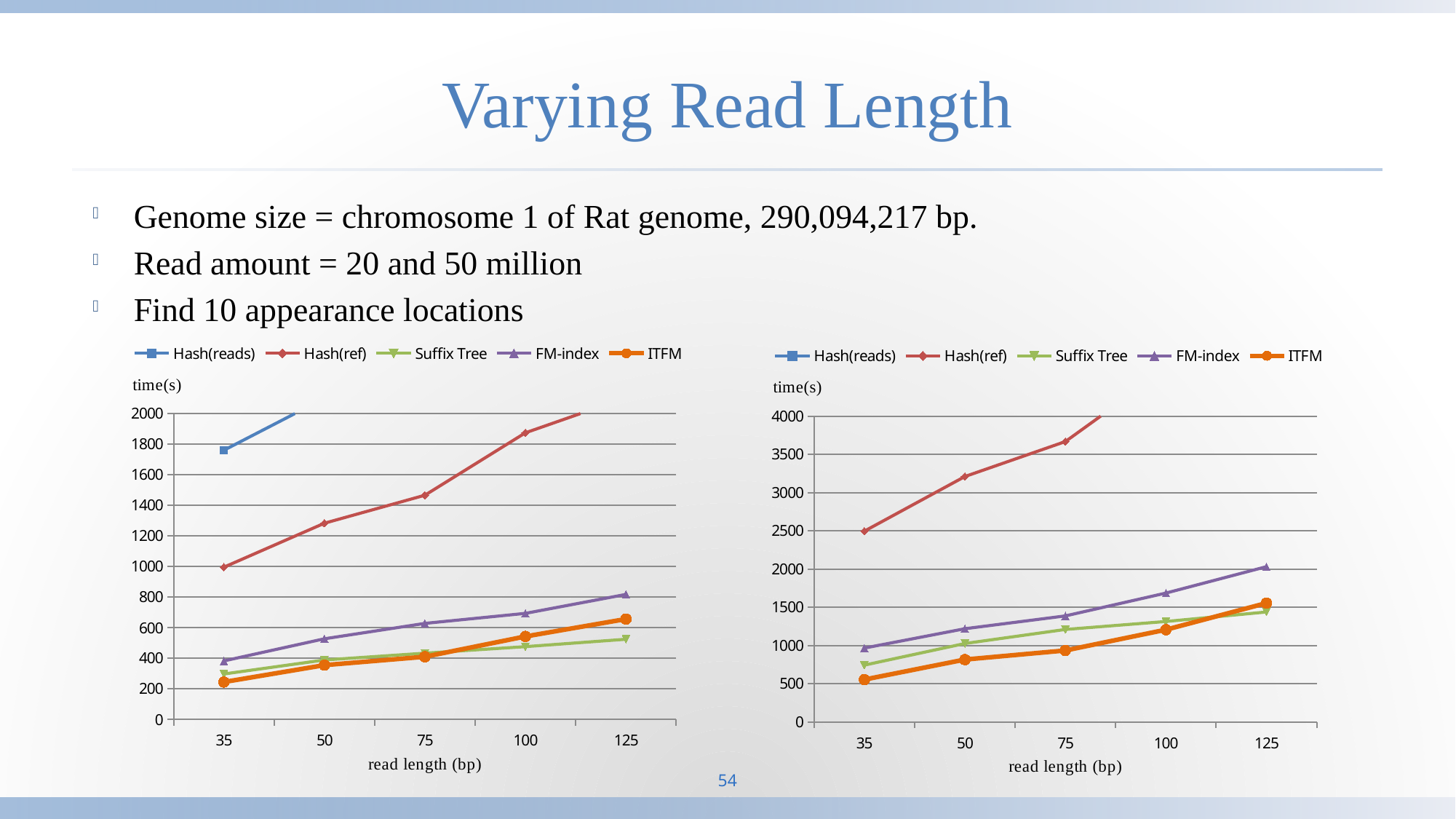
In the left chart, is the value for ITFM at read length 35 greater or less than 400? less How many read length values are shown on the x axis of the left chart? 5 In the left chart, which is larger at read length 125: FM-index or Suffix Tree? FM-index In the right chart, which series has the lowest value at read length 35? ITFM In the left chart, is the value for Hash(ref) at read length 35 greater or less than 800? greater What is the x axis title of the right chart? read length (bp) In the right chart, is the value for Hash(ref) at read length 35 greater or less than 2000? greater In the left chart, does the ITFM series rise or fall as read length increases? rise How many series does the legend of the right chart list? 5 What kind of chart is the left chart on the slide? line chart